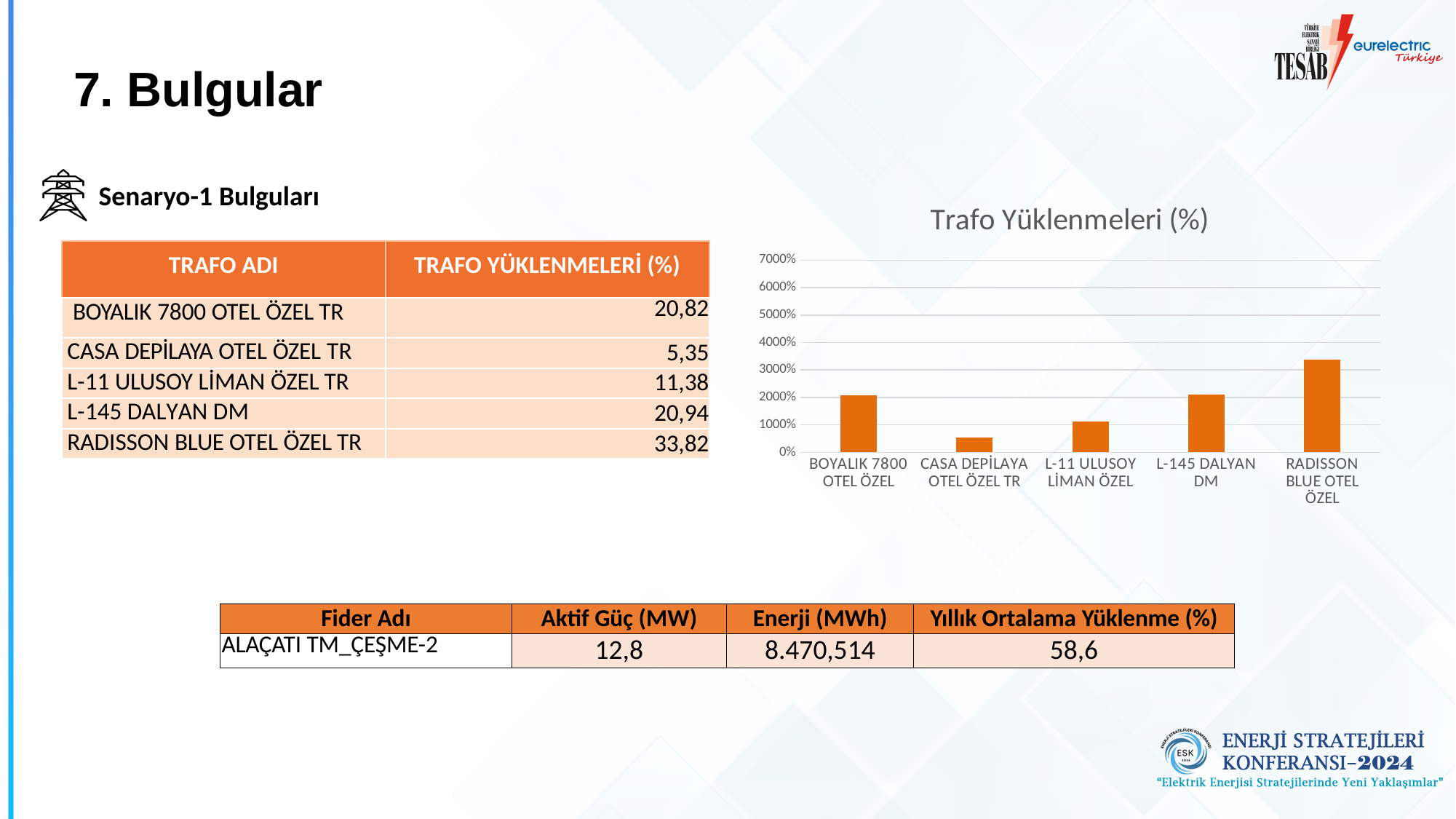
Is the bar for RADISSON BLUE OTEL ÖZEL greater or less than 3000%? greater Which category has the lowest bar in the chart? CASA DEPİLAYA OTEL ÖZEL TR Is the bar for BOYALIK 7800 OTEL ÖZEL greater or less than 3000%? less How many categories are plotted in the chart? 5 What is the title of the chart? Trafo Yüklenmeleri (%) What kind of chart is shown on the slide? bar chart Which category has the highest bar in the chart? RADISSON BLUE OTEL ÖZEL Which bar is taller, L-11 ULUSOY LİMAN ÖZEL or L-145 DALYAN DM? L-145 DALYAN DM What colour are the bars in the chart? orange Which bar is taller, CASA DEPİLAYA OTEL ÖZEL TR or RADISSON BLUE OTEL ÖZEL? RADISSON BLUE OTEL ÖZEL Is the bar for CASA DEPİLAYA OTEL ÖZEL TR greater or less than 1000%? less